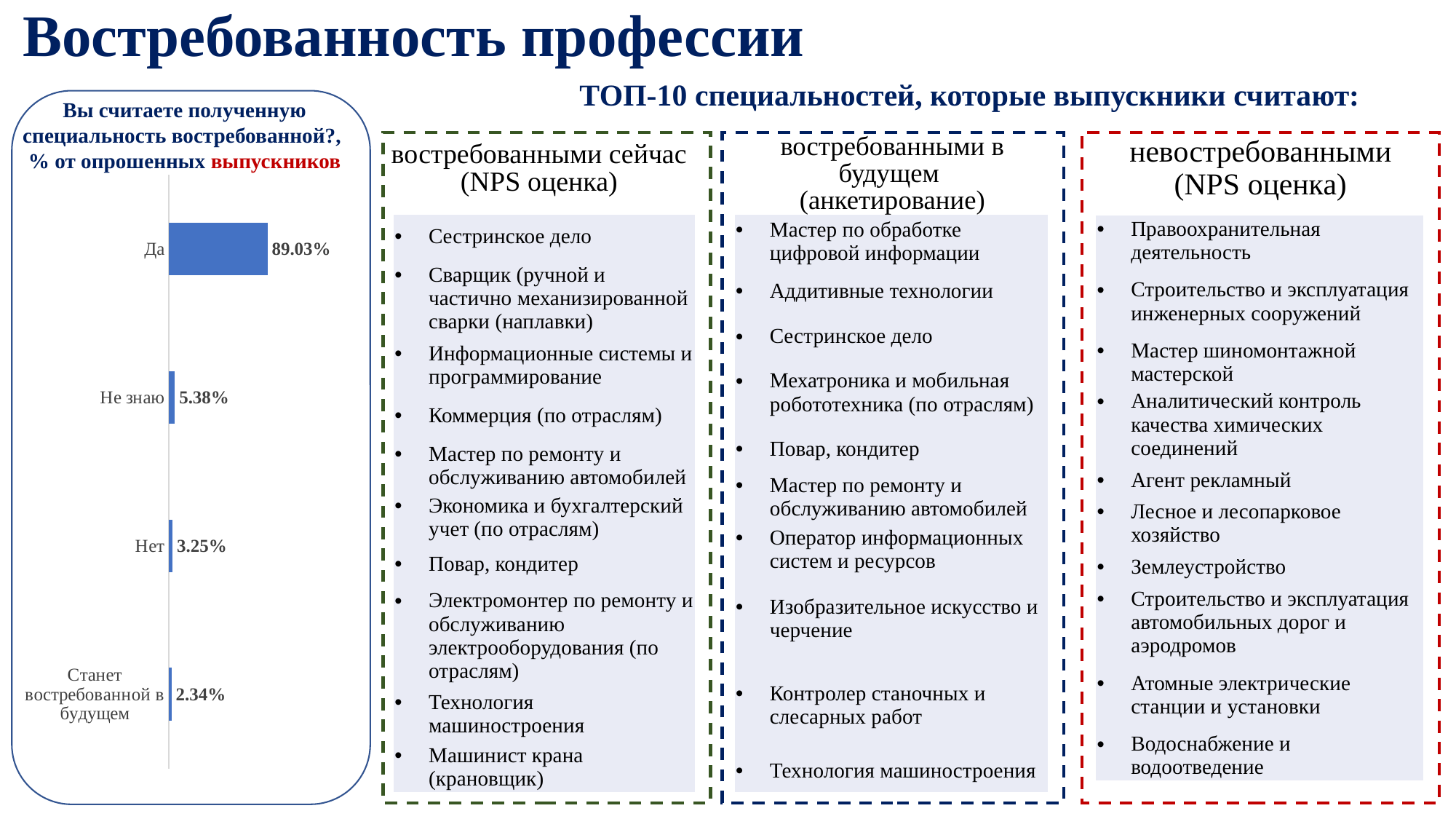
Which category has the highest value in the bar chart? Да What is the value for "Станет востребованной в будущем" in the bar chart? 2.34% Which category has the lowest value in the bar chart? Станет востребованной в будущем What is the value for "Нет" in the bar chart? 3.25% What kind of chart is shown on the slide? Bar chart What is the value for "Да" in the bar chart? 89.03% What is the difference between the values for "Да" and "Не знаю" in the bar chart? 83.65% How many categories are shown in the bar chart? 4 Which is larger in the bar chart: the value for "Не знаю" or the value for "Нет"? Не знаю What is the title of the bar chart? Вы считаете полученную специальность востребованной?, % от опрошенных выпускников What is the value for "Не знаю" in the bar chart? 5.38% What is the difference between the values for "Нет" and "Станет востребованной в будущем" in the bar chart? 0.91%